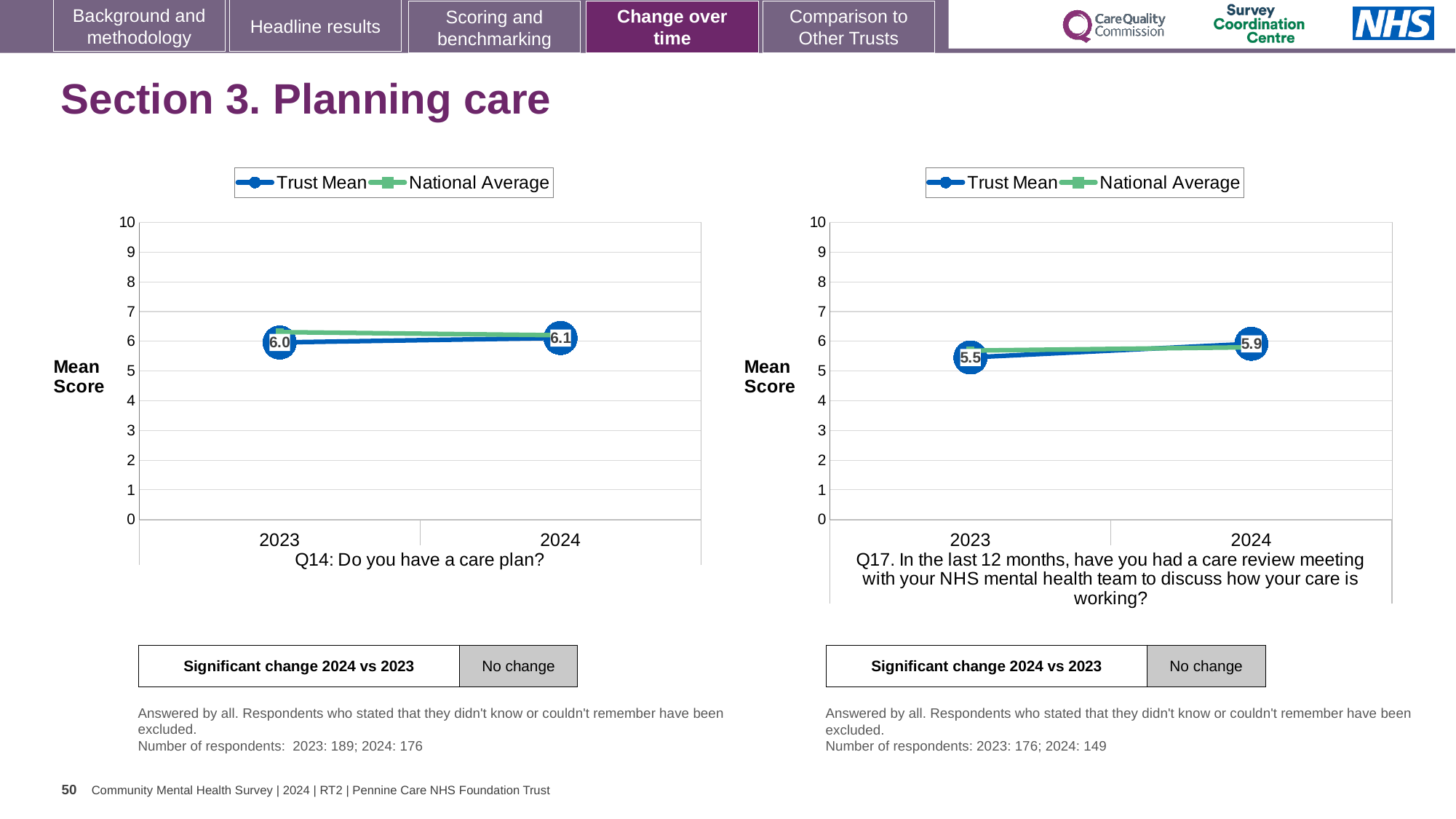
In the Q17 chart (right), by how much did the Trust Mean change from 2023 to 2024? 0.4 In the Q14 chart (left), what is the Trust Mean for 2024? 6.1 In the Q14 chart (left), what is the Trust Mean for 2023? 6.0 In the Q17 chart (right), what is the Trust Mean for 2024? 5.9 In the Q14 chart (left), is the National Average for 2023 greater or less than 5? greater How many years are plotted on the x axis of the Q14 chart (left)? 2 What are the two series named in the legend of the Q14 chart (left)? Trust Mean and National Average In the Q14 chart (left), does the Trust Mean rise or fall from 2023 to 2024? rise What kind of chart is the Q14 chart (left)? line chart How many series does the legend of the Q17 chart (right) list? 2 In the Q17 chart (right), which year has the higher Trust Mean, 2023 or 2024? 2024 In the Q17 chart (right), what is the Trust Mean for 2023? 5.5